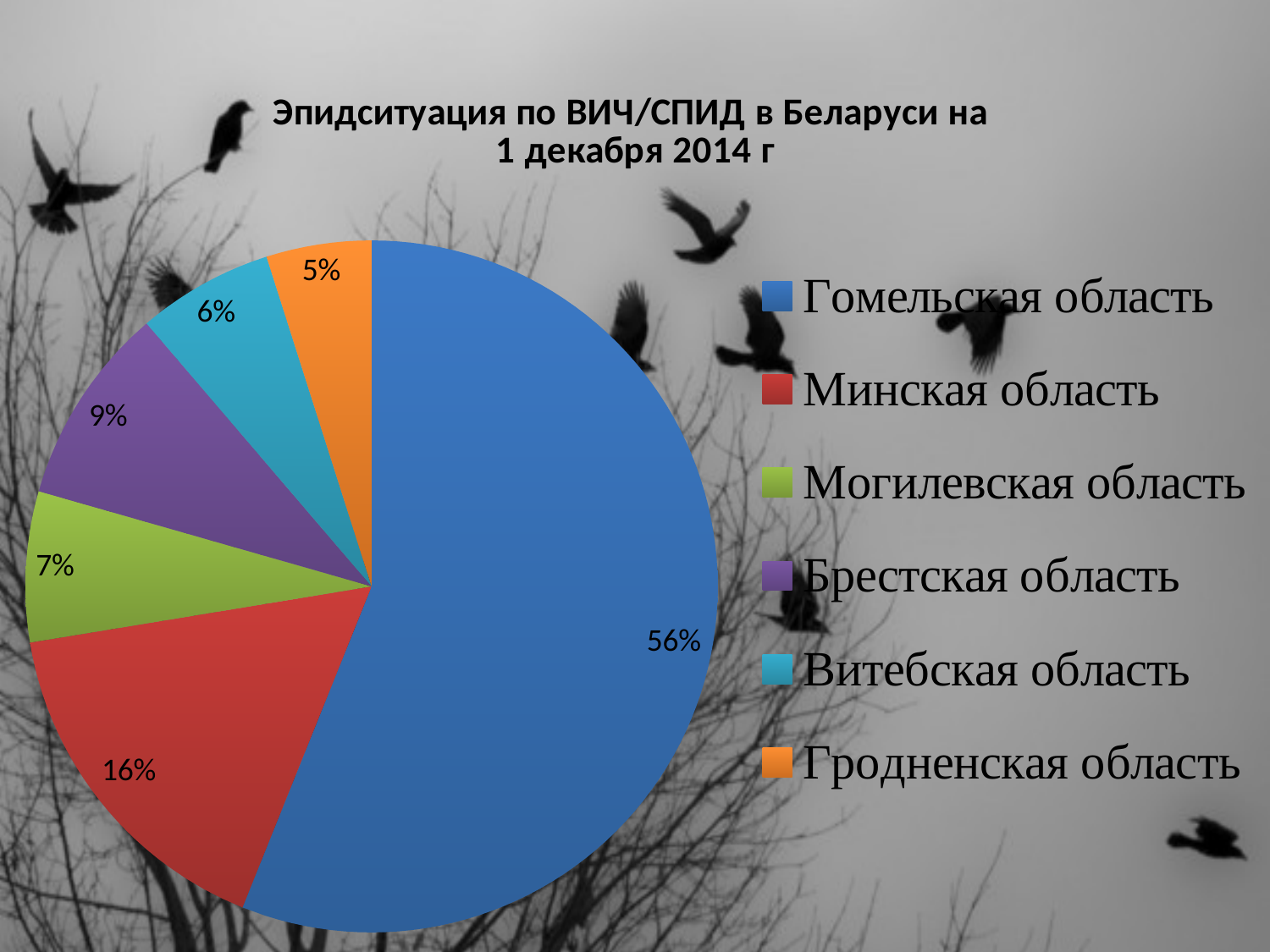
Which is larger, the share for Брестская область or the share for Могилевская область? Брестская область What is the difference in percentage points between Гомельская область and Минская область? 40 What share of the pie does Минская область have? 16% What share of the pie does Витебская область have? 6% What kind of chart is shown on the slide? pie chart What share of the pie does Могилевская область have? 7% How many regions does the legend list? 6 Which region has the smallest slice of the pie? Гродненская область Which region has the largest slice of the pie? Гомельская область